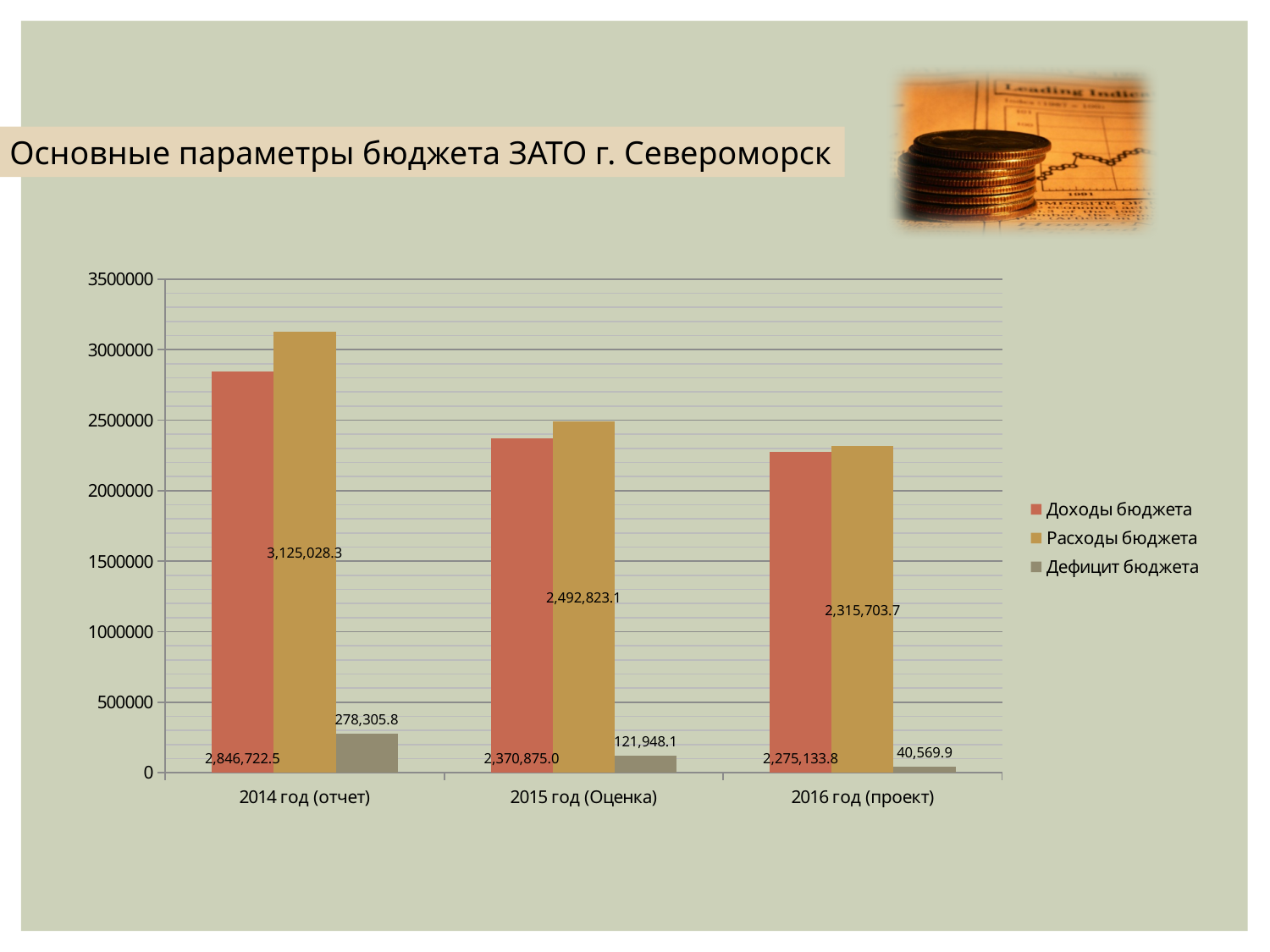
What is the difference between Расходы бюджета and Доходы бюджета for 2015 год (Оценка)? 121,948.1 In which year is Доходы бюджета the lowest? 2016 год (проект) Do the Расходы бюджета values rise or fall from 2014 to 2016? fall Which is larger for 2014 год (отчет): Доходы бюджета or Расходы бюджета? Расходы бюджета What is the value of Доходы бюджета for 2015 год (Оценка)? 2,370,875.0 What type of chart is shown on the slide? bar chart Is the value of Дефицит бюджета for 2014 год (отчет) greater or less than 500000? less What is the value of Расходы бюджета for 2014 год (отчет)? 3,125,028.3 In which year is Дефицит бюджета the highest? 2014 год (отчет) What is the value of Дефицит бюджета for 2016 год (проект)? 40,569.9 How many year categories are shown on the x axis? 3 How many series does the legend list? 3